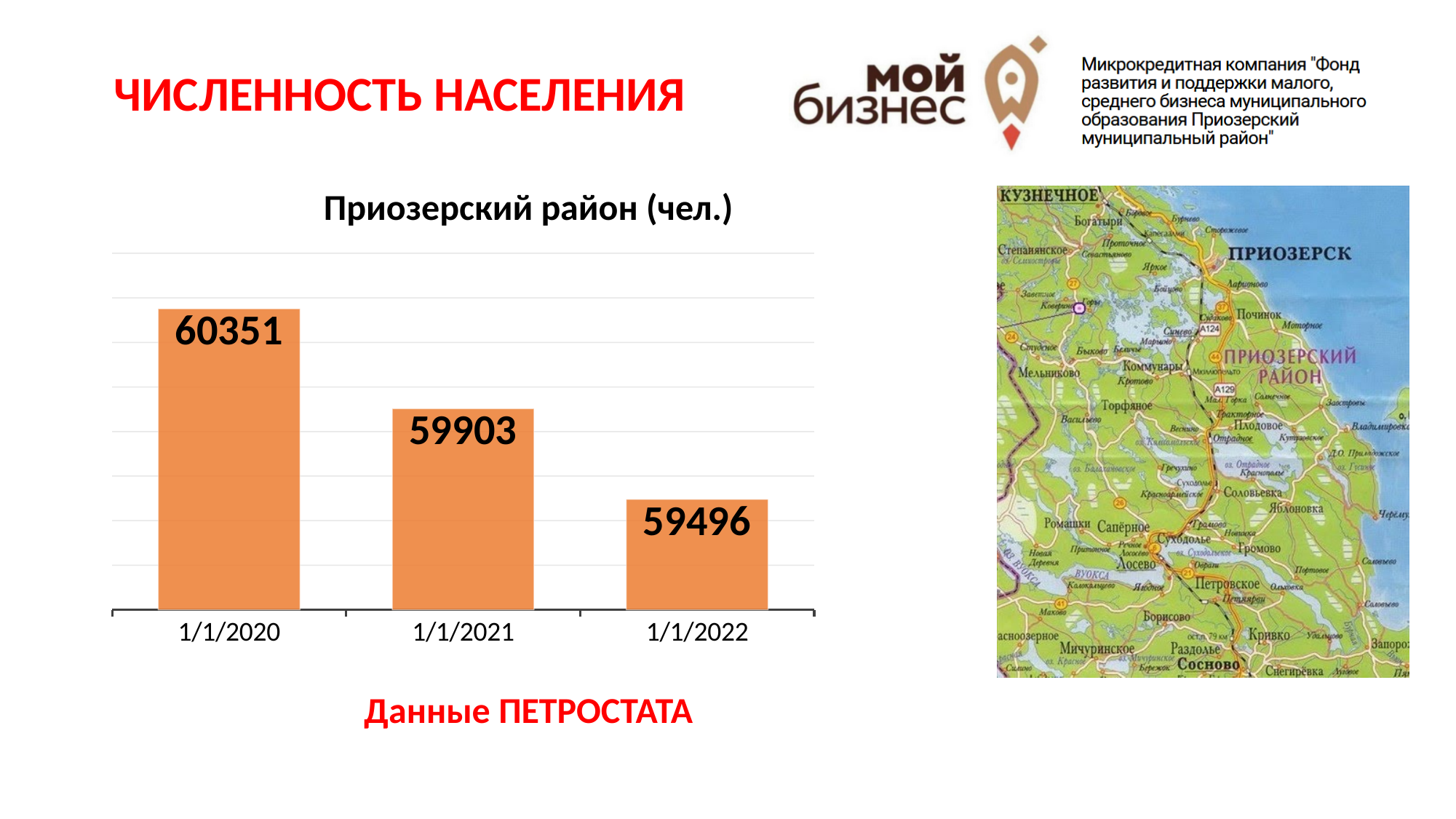
What kind of chart is shown on the slide? bar chart What is the difference between the population on 1/1/2020 and on 1/1/2021? 448 What is the population value shown for 1/1/2021? 59903 What is the population value shown for 1/1/2022? 59496 What is the difference between the population on 1/1/2020 and on 1/1/2022? 855 How many dates (bars) are shown in the chart? 3 What is the difference between the population on 1/1/2021 and on 1/1/2022? 407 Do the population values rise or fall from 1/1/2020 to 1/1/2022? fall What is the population value shown for 1/1/2020? 60351 Which date has the lowest population value? 1/1/2022 Which is larger, the population on 1/1/2021 or on 1/1/2022? 1/1/2021 Which date has the highest population value? 1/1/2020